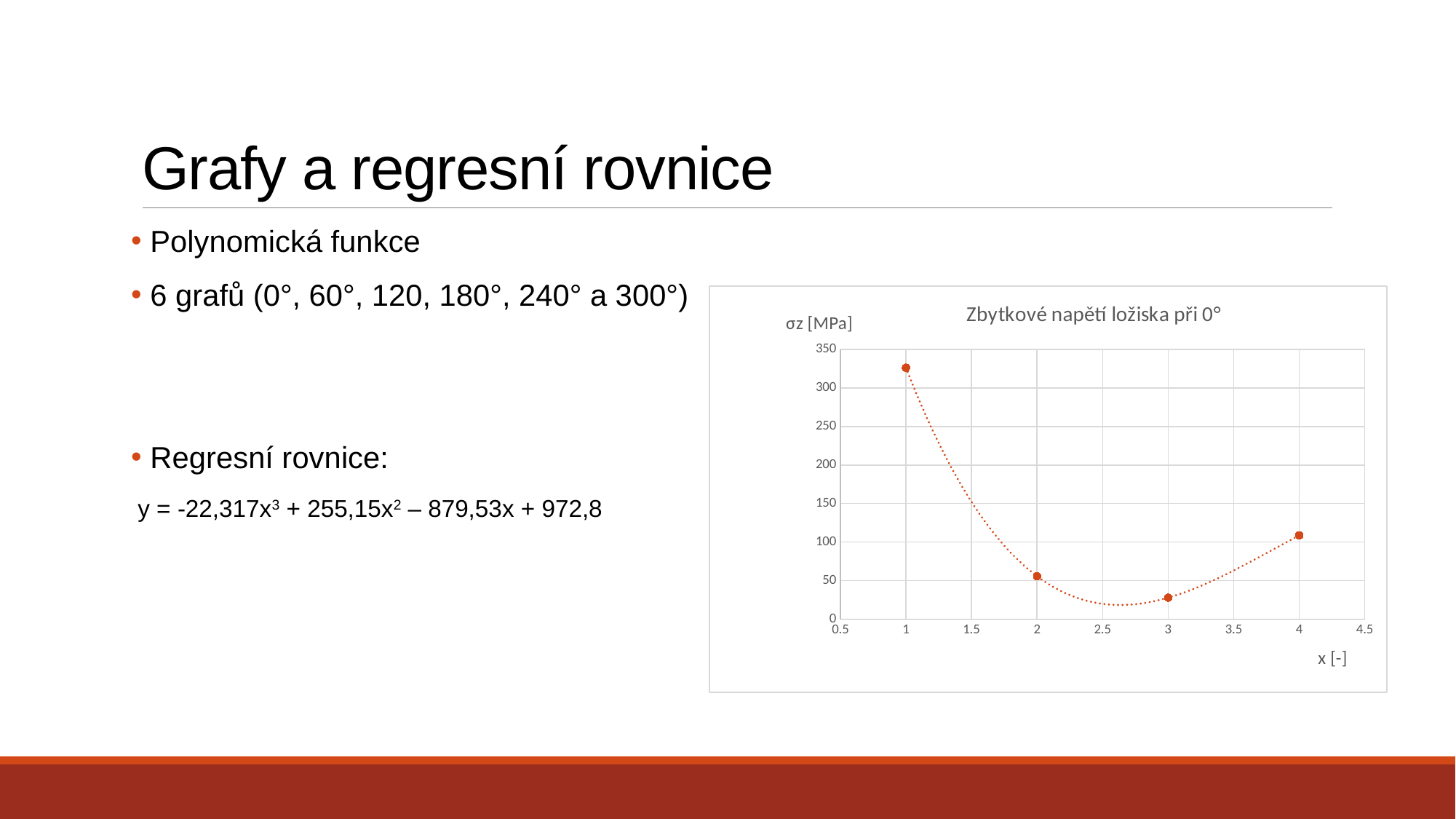
At which x value is the plotted σz value lowest? 3 Is the value for x = 1 greater or less than 300? greater Which has the larger σz value, x = 2 or x = 4? x = 4 How many data points are plotted in the chart? 4 What kind of chart is shown on the slide? scatter chart Do the plotted values rise or fall from x = 1 to x = 3? fall At which x value is the plotted σz value highest? 1 Is the value for x = 3 greater or less than 50? less Is the value for x = 2 greater or less than 100? less What is the label of the vertical axis of the chart? σz [MPa] What is the title of the chart? Zbytkové napětí ložiska při 0°